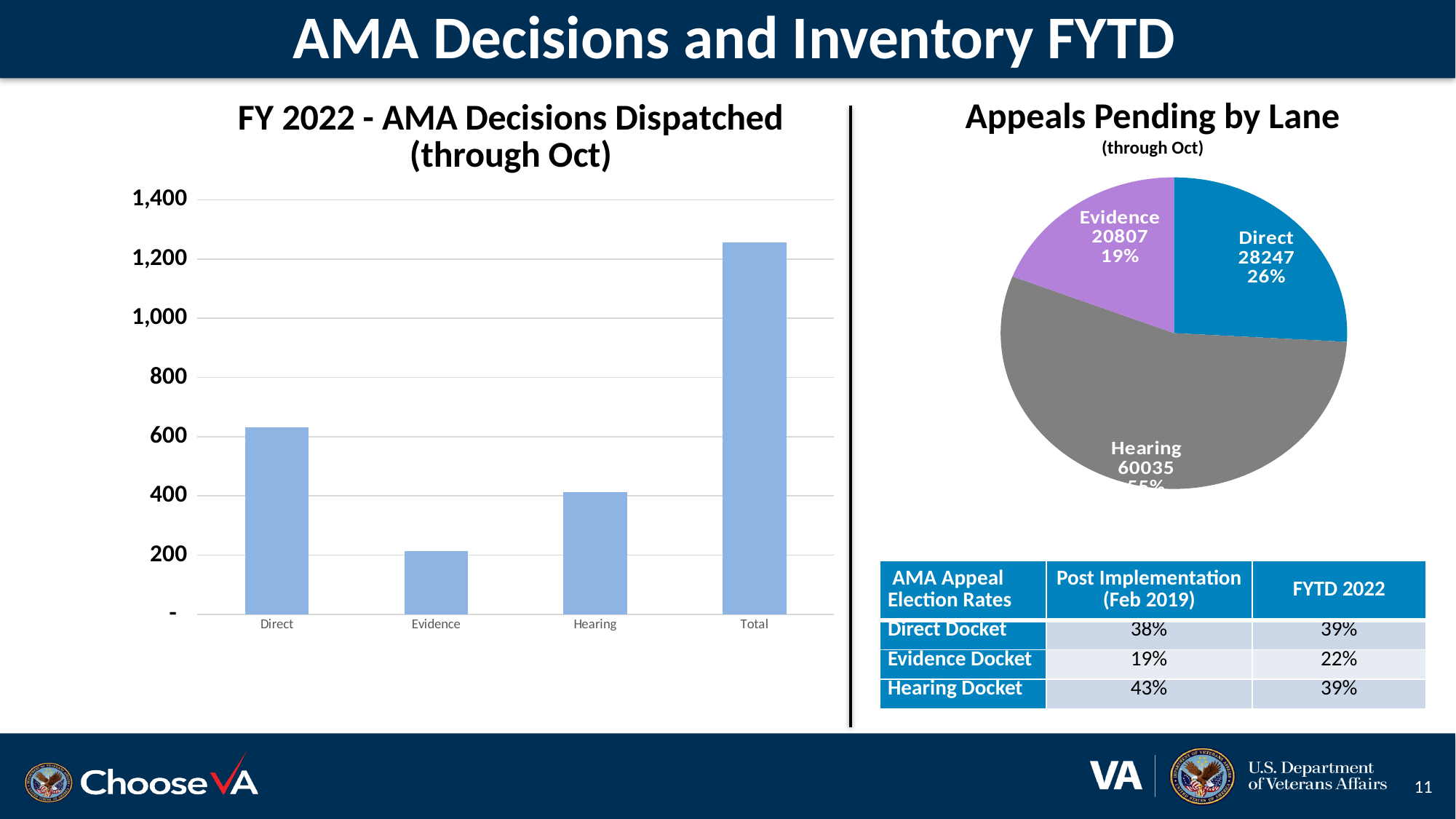
In the 'FY 2022 - AMA Decisions Dispatched' bar chart, which category has the tallest bar? Total In the 'FY 2022 - AMA Decisions Dispatched' bar chart, which is larger, the bar for Direct or the bar for Hearing? Direct In the 'FY 2022 - AMA Decisions Dispatched' bar chart, is the value for Evidence greater or less than 400? less In the 'Appeals Pending by Lane' pie chart, how many more appeals are pending in the Direct lane than in the Evidence lane? 7440 In the 'Appeals Pending by Lane' pie chart, what is the number of appeals pending in the Direct lane? 28247 In the 'FY 2022 - AMA Decisions Dispatched' bar chart, is the value for Direct greater or less than 400? greater How many categories are shown on the x axis of the 'FY 2022 - AMA Decisions Dispatched' bar chart? 4 What kind of chart is the 'FY 2022 - AMA Decisions Dispatched (through Oct)' chart? bar chart In the 'FY 2022 - AMA Decisions Dispatched' bar chart, which category has the shortest bar? Evidence In the 'Appeals Pending by Lane' pie chart, which lane has the largest slice? Hearing In the 'FY 2022 - AMA Decisions Dispatched' bar chart, is the value for Total greater or less than 1,200? greater In the 'Appeals Pending by Lane' pie chart, what share of the pie does the Evidence lane represent? 19%